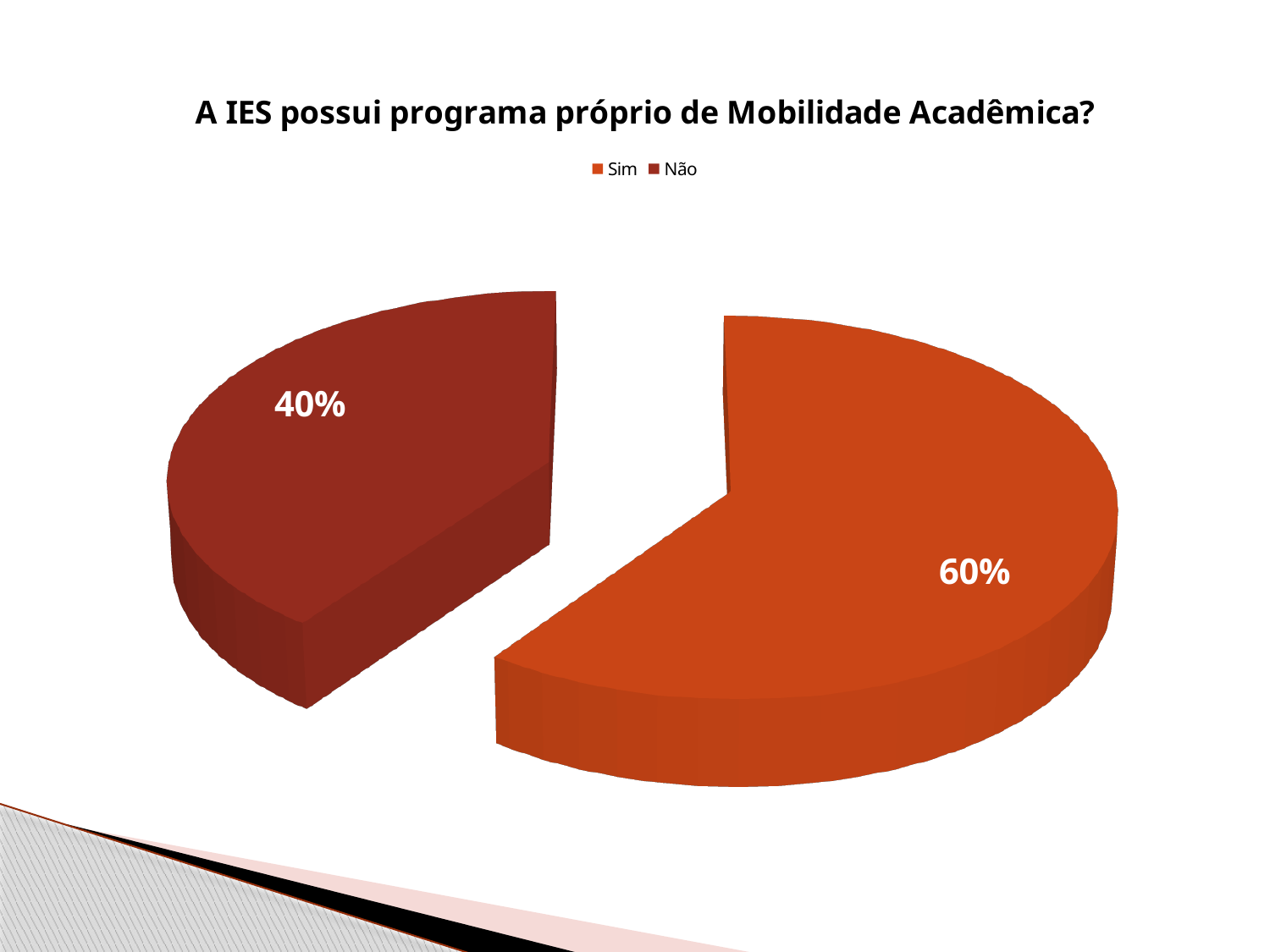
What share of the pie does the "Não" slice represent? 40% Which is larger, the "Sim" slice or the "Não" slice? Sim What share of the pie does the "Sim" slice represent? 60% Which legend entry is shown in the darker red colour? Não What kind of chart is shown on the slide? Pie chart Which slice is the largest? Sim Which slice is the smallest? Não What is the title of the chart? A IES possui programa próprio de Mobilidade Acadêmica? How many slices does the pie chart have? 2 What is the difference in percentage points between the "Sim" and "Não" slices? 20% How many entries does the legend list? 2